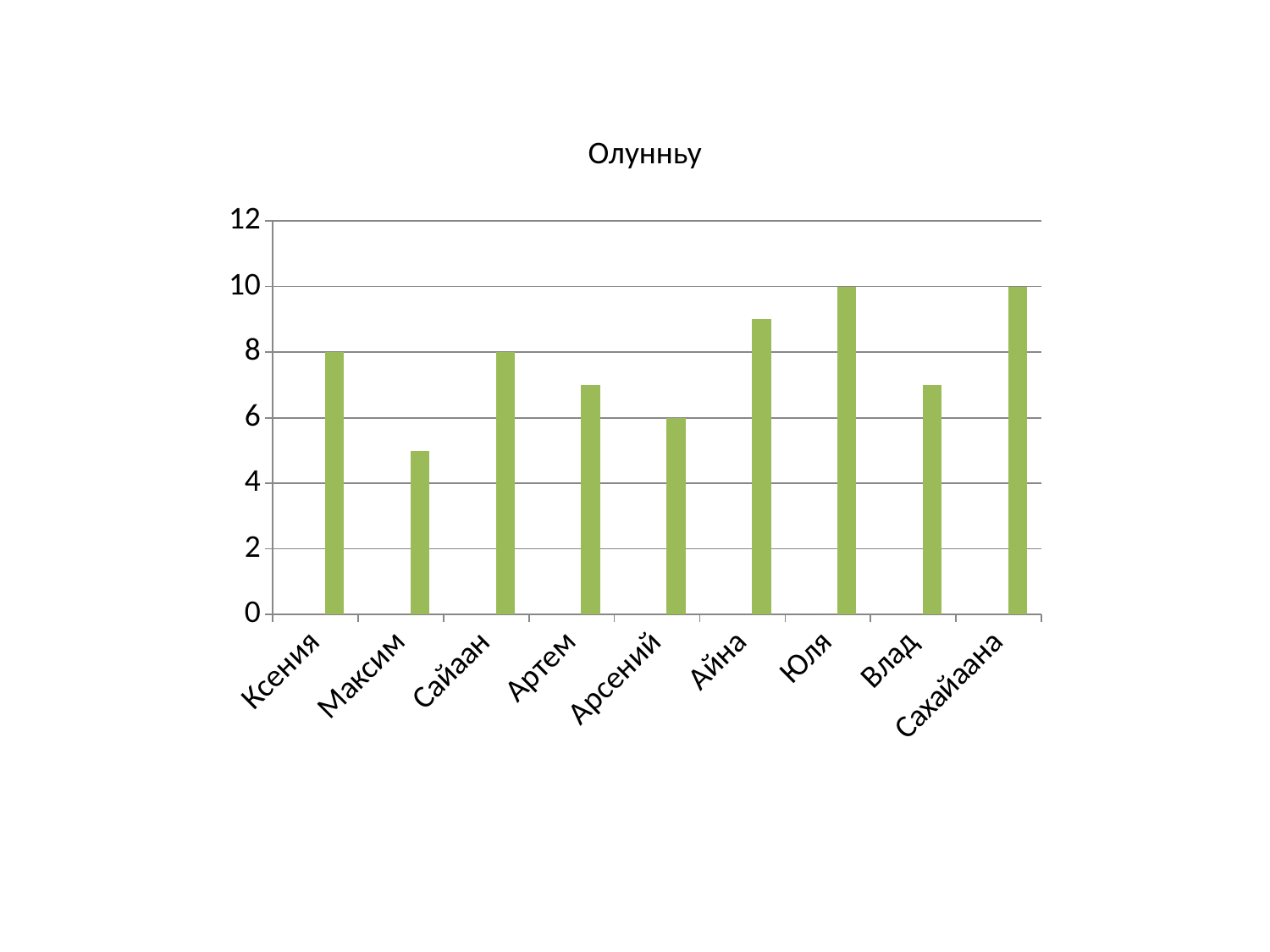
What is the value for Сахайаана? 10 Is the value for Айна greater or less than 8? greater Is the value for Максим greater or less than 6? less What is the value for Ксения? 8 Which is larger, the value for Айна or the value for Максим? Айна What is the title of the chart? Олунньу How many categories are shown on the x axis of the chart? 9 What is the difference between the values for Юля and Ксения? 2 What is the value for Юля? 10 What kind of chart is shown on the slide? bar chart Which category has the lowest value? Максим What is the value for Арсений? 6